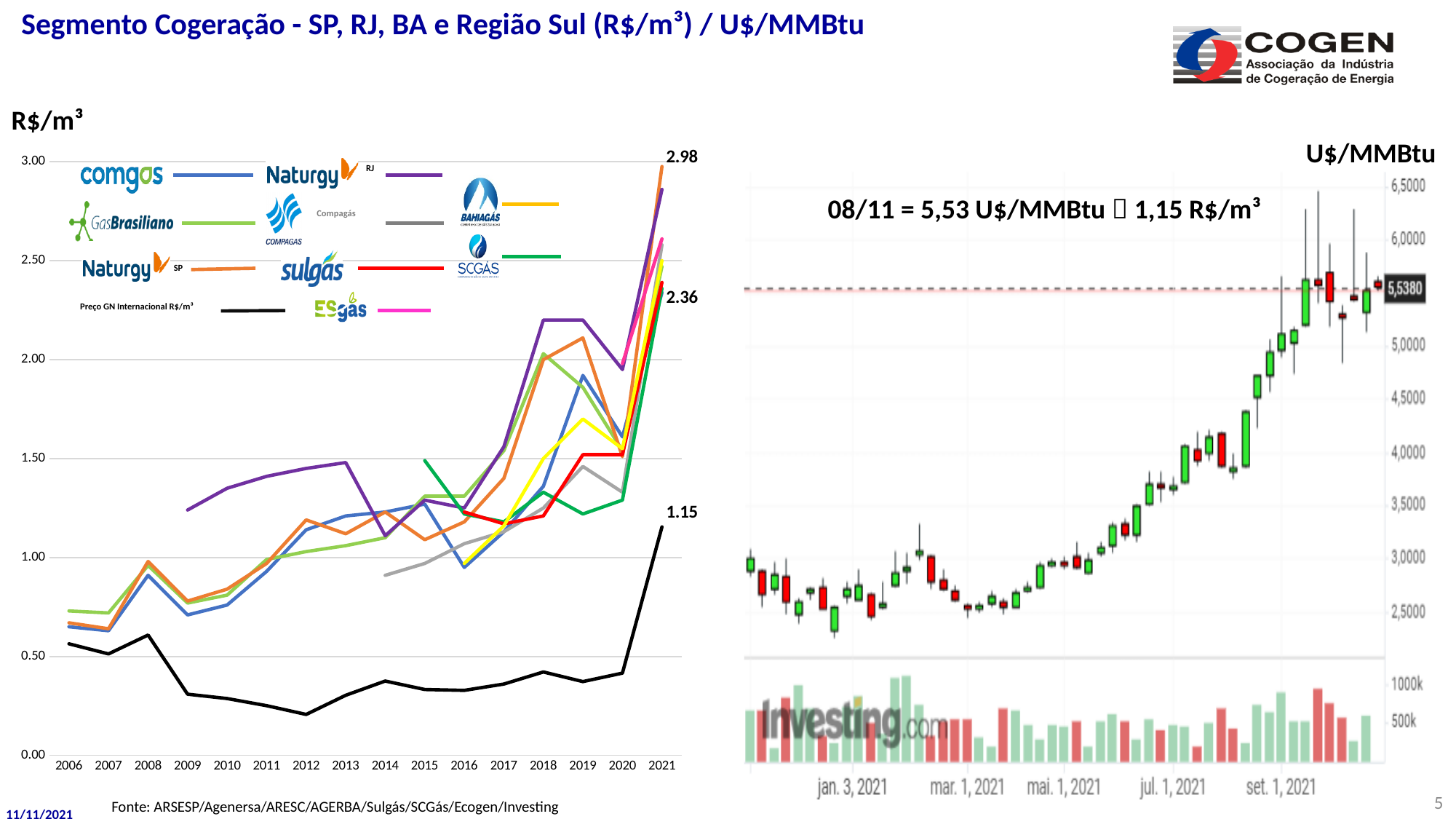
What kind of chart is the right chart (U$/MMBtu)? Candlestick chart On the right chart (U$/MMBtu), what is the last price shown on the right-hand axis label? 5,5380 On the left chart (R$/m³), what is the value labelled for the black Preço GN Internacional line in 2021? 1.15 On the left chart (R$/m³), how many series does the legend list? 10 What kind of chart is the left chart (R$/m³)? Line chart On the left chart (R$/m³), what is the difference between the 2.98 and 2.36 labels shown for 2021? 0.62 On the left chart (R$/m³), is the value of the Naturgy RJ line in 2018 greater or less than 2.00? greater On the left chart (R$/m³), how many years are shown on the x axis? 16 On the left chart (R$/m³), is the value of the black Preço GN Internacional line in 2012 greater or less than 0.50? less On the left chart (R$/m³), what is the highest value labelled at the 2021 end of the lines? 2.98 On the right chart (U$/MMBtu), does the price generally rise or fall from jan. 3, 2021 to the end of the chart? Rises On the left chart (R$/m³), does the black Preço GN Internacional line rise or fall from 2020 to 2021? Rises